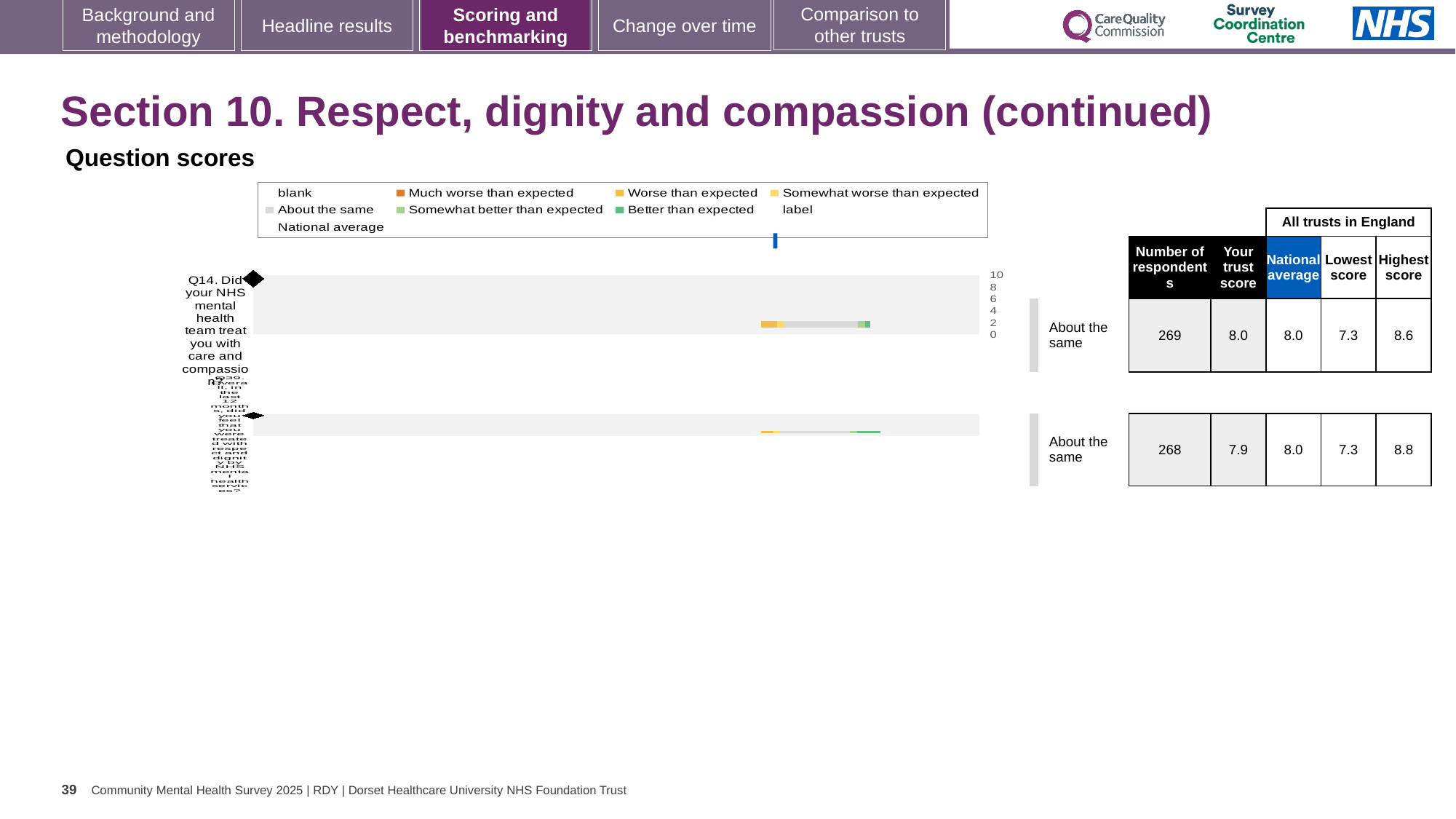
What is the trust score for Q14 (treated with care and compassion)? 8.0 What is the trust score for Q39? 7.9 What is the national average for Q39? 8.0 What kind of chart is shown under 'Question scores'? bar chart How many questions are plotted in the chart? 2 What is the difference between the highest and lowest scores for Q39? 1.5 What is the difference between the highest and lowest scores for Q14? 1.3 Which question has the higher trust score, Q14 or Q39? Q14 What is the highest score among all trusts in England for Q39? 8.8 What is the maximum value shown on the chart's score axis? 10 What benchmark category is shown for Q14? About the same How many respondents answered Q14? 269